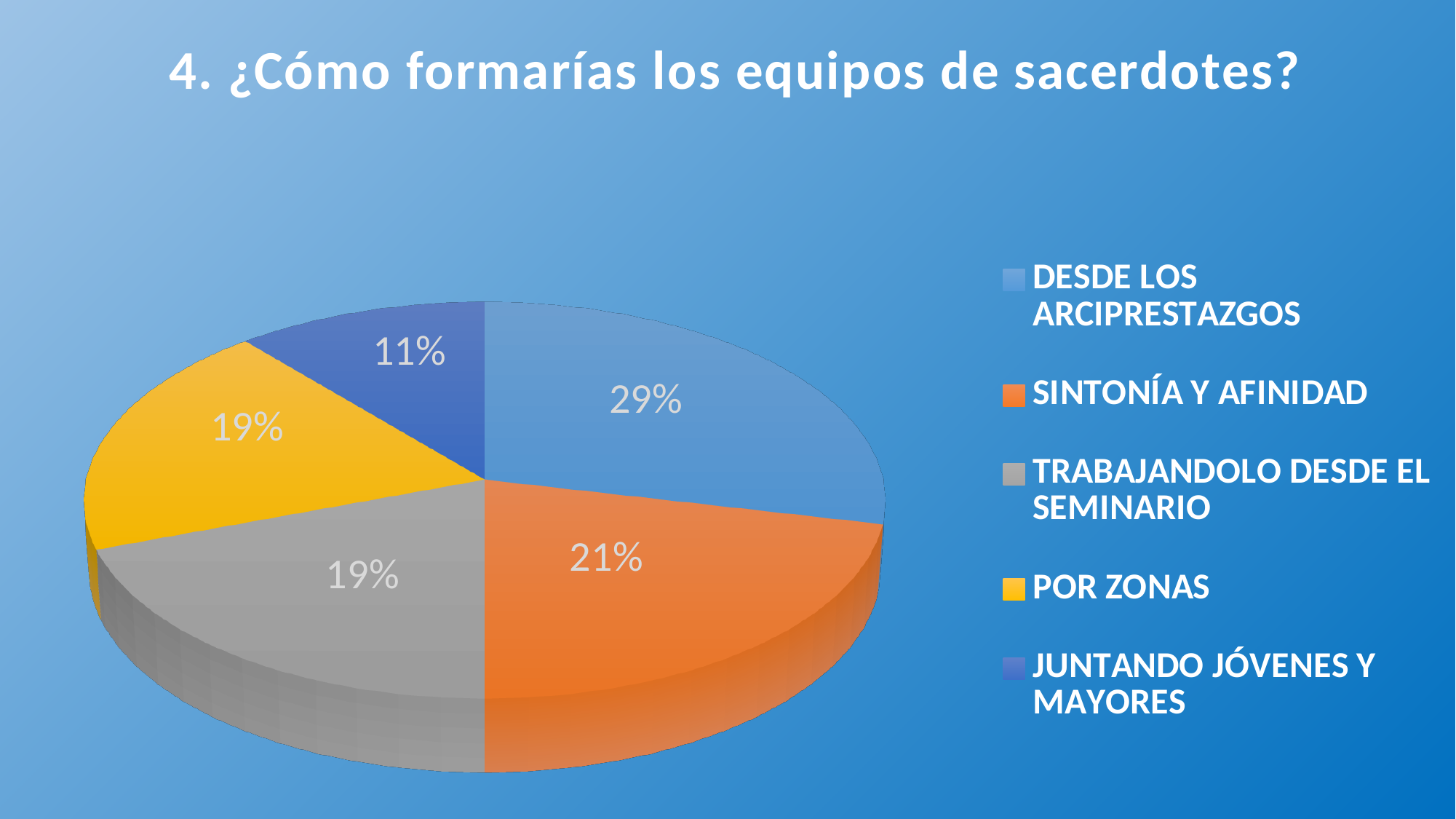
Which category has the largest slice of the pie? DESDE LOS ARCIPRESTAZGOS Which category has the smallest slice of the pie? JUNTANDO JÓVENES Y MAYORES What is the difference in percentage points between DESDE LOS ARCIPRESTAZGOS and SINTONÍA Y AFINIDAD? 8 What kind of chart is shown on the slide? pie chart What percentage is shown for POR ZONAS? 19% Which is larger, SINTONÍA Y AFINIDAD or TRABAJANDOLO DESDE EL SEMINARIO? SINTONÍA Y AFINIDAD What share of the pie does DESDE LOS ARCIPRESTAZGOS have? 29% What is the title of the chart? 4. ¿Cómo formarías los equipos de sacerdotes? What percentage is shown for SINTONÍA Y AFINIDAD? 21% How many categories does the pie chart have? 5 What colour is the slice for POR ZONAS? yellow What percentage is shown for JUNTANDO JÓVENES Y MAYORES? 11%